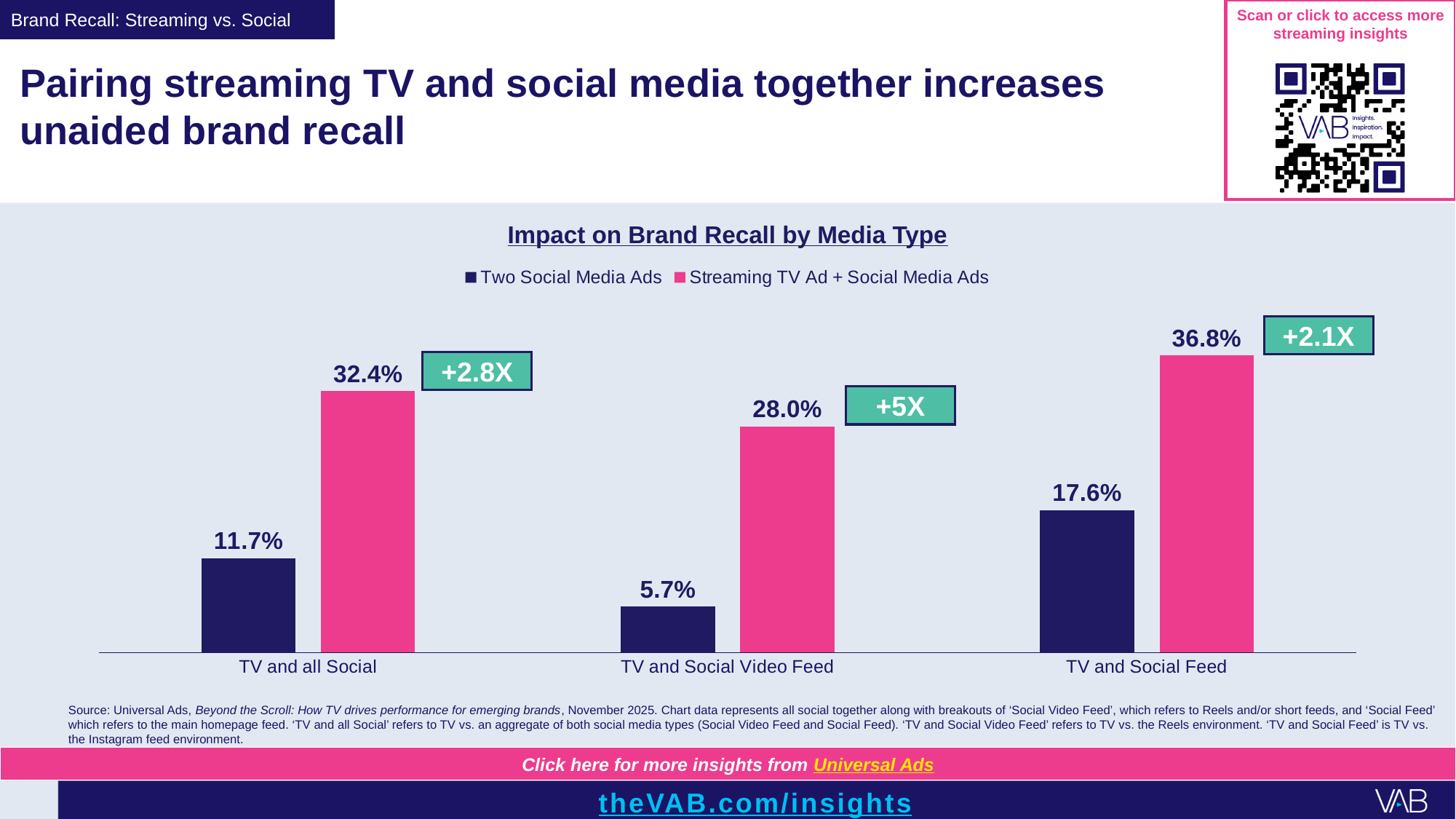
Which is larger in the TV and Social Feed category: Two Social Media Ads or Streaming TV Ad + Social Media Ads? Streaming TV Ad + Social Media Ads What is the difference between the Streaming TV Ad + Social Media Ads value and the Two Social Media Ads value in the TV and all Social category? 20.7% Which category has the highest value for Streaming TV Ad + Social Media Ads? TV and Social Feed What is the title of the chart? Impact on Brand Recall by Media Type What kind of chart is shown? Bar chart Which category has the lowest value for Two Social Media Ads? TV and Social Video Feed What is the value for Streaming TV Ad + Social Media Ads in the TV and Social Video Feed category? 28.0% What multiplier label is shown next to the TV and Social Video Feed bars? +5X How many series does the legend list? 2 How many categories are shown on the x axis? 3 What is the value for Two Social Media Ads in the TV and Social Feed category? 17.6% What is the value for Two Social Media Ads in the TV and all Social category? 11.7%